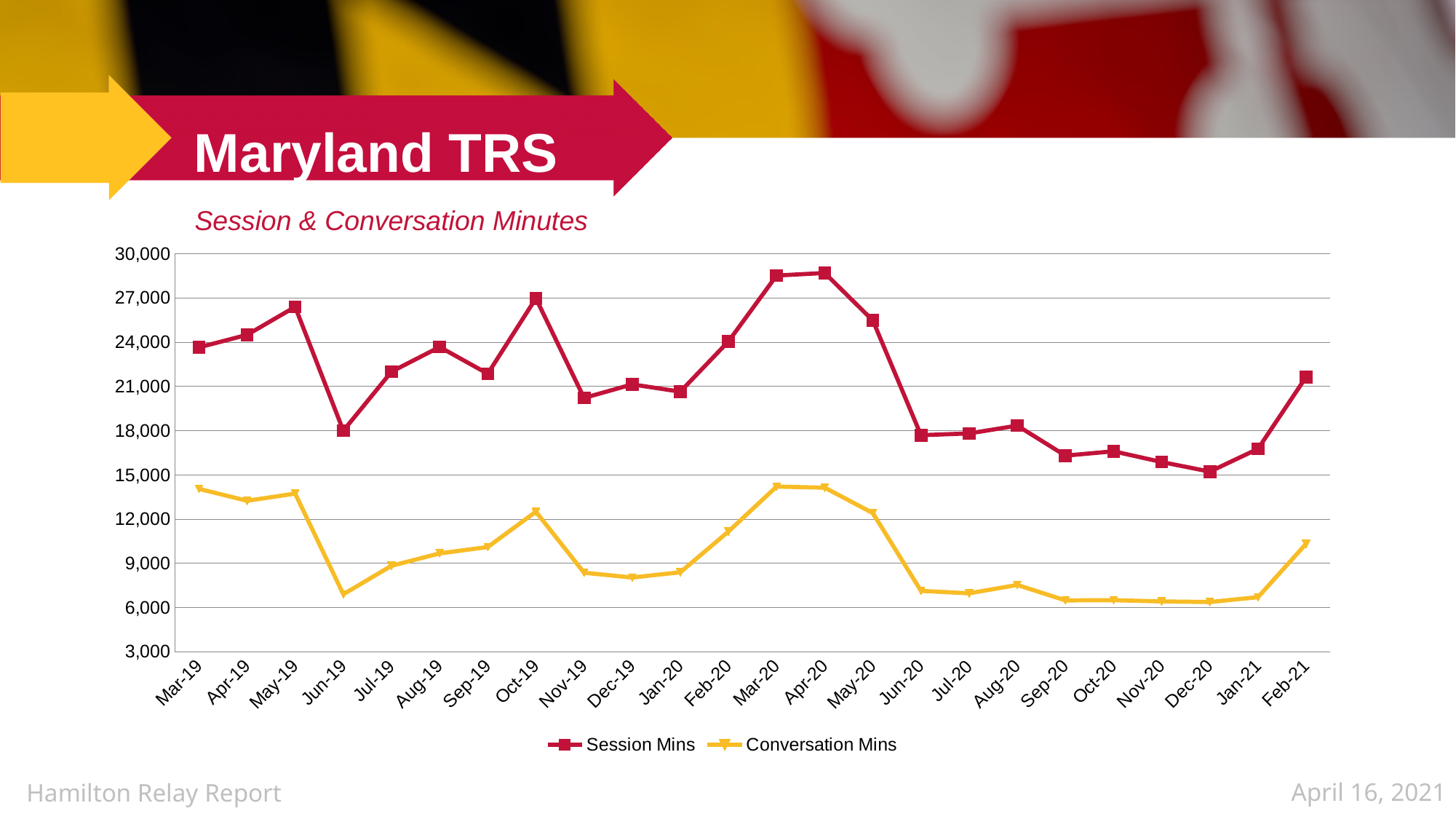
Which is larger, the Session Mins value for Oct-19 or for Nov-19? Oct-19 Is the Conversation Mins value for Nov-19 greater or less than 9,000? less Is the Session Mins value for Sep-20 greater or less than 18,000? less What is the title of the chart? Session & Conversation Minutes How many series does the chart legend list? 2 Which month has the lowest Session Mins value? Dec-20 Which is larger, the Conversation Mins value for Mar-19 or for Jun-19? Mar-19 What kind of chart is shown on the slide? Line chart Is the Session Mins value for Mar-20 greater or less than 27,000? greater Do the Session Mins values rise or fall from Apr-20 to Jun-20? fall How many months are plotted along the x axis? 24